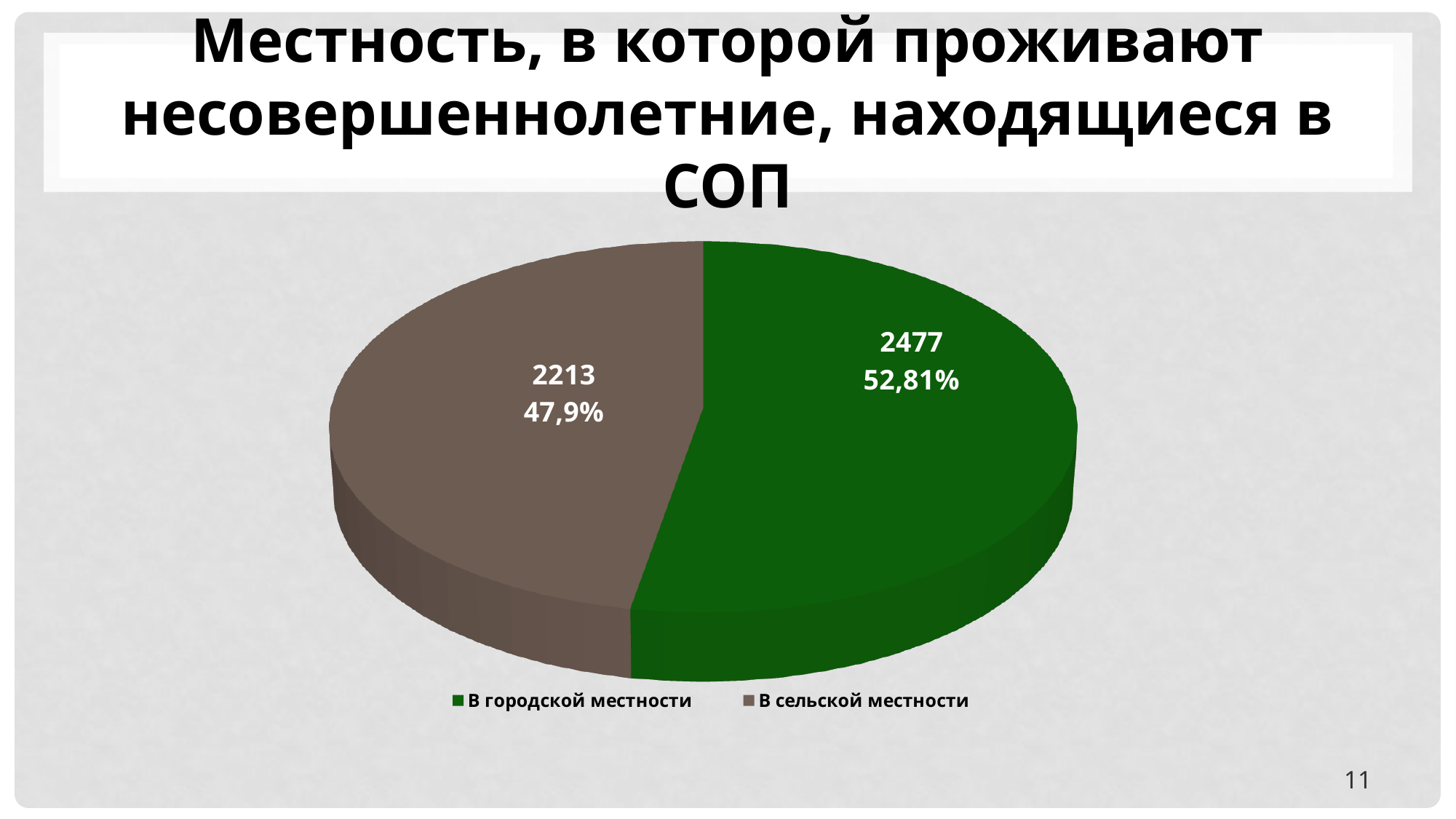
What percentage share is shown for «В сельской местности»? 47,9% What kind of chart is shown on the slide? Pie chart What percentage share is shown for «В городской местности»? 52,81% What is the value for «В городской местности»? 2477 What is the total of the two values shown on the pie chart? 4690 Which category has the smallest slice? В сельской местности Which category has the largest slice? В городской местности How many slices does the pie chart have? 2 What is the difference between the values for «В городской местности» and «В сельской местности»? 264 Which is larger: the value for «В городской местности» or «В сельской местности»? В городской местности What is the value for «В сельской местности»? 2213 What colour is the slice for «В сельской местности»? Brown